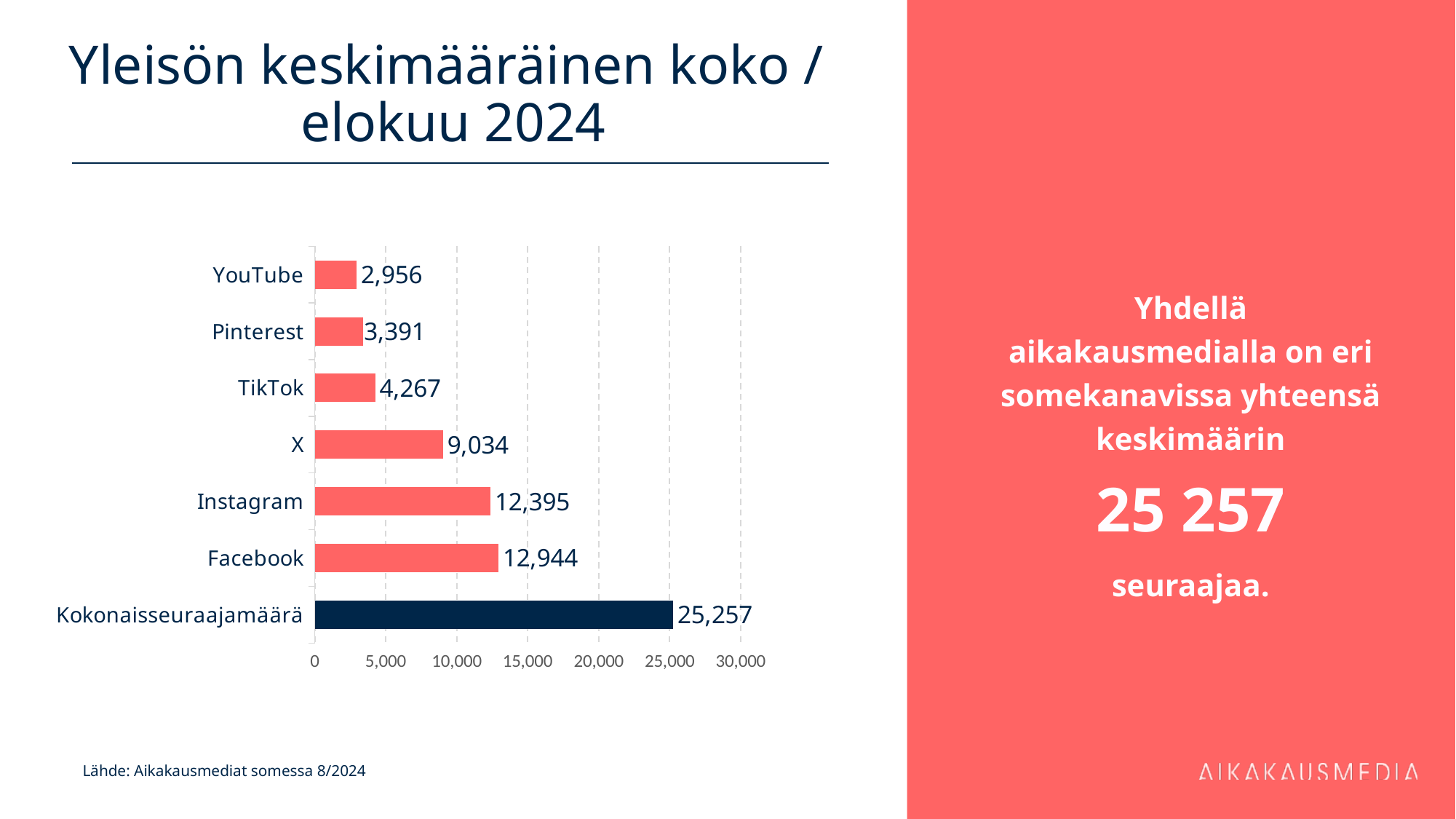
What is the value for Instagram? 12,395 What is the value for Kokonaisseuraajamäärä? 25,257 Which category has the lowest value? YouTube Which has a larger value, X or TikTok? X What kind of chart is shown on the slide? bar chart What is the title of the chart on the slide? Yleisön keskimääräinen koko / elokuu 2024 Which category has the highest value? Kokonaisseuraajamäärä What is the value for YouTube? 2,956 How many categories are shown in the chart? 7 What is the difference between the values for X and TikTok? 4,767 Is the value for Pinterest greater or less than 5,000? less What is the difference between the values for Facebook and Instagram? 549